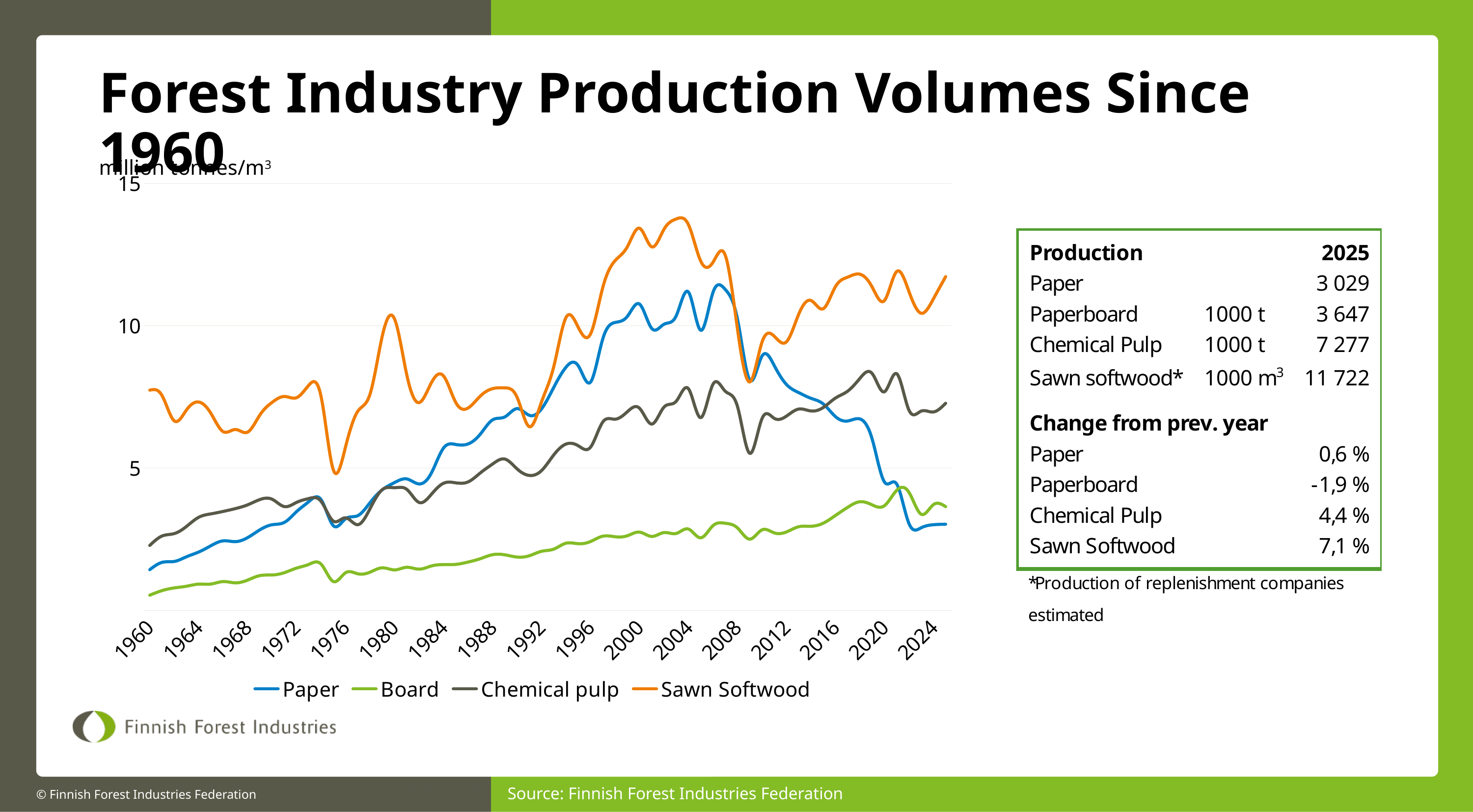
Is the value for Board in 1960 greater or less than 5? less In 2024, which is higher: Chemical pulp or Paper? Chemical pulp Does the Paper series rise or fall between 2008 and 2024? fall Is the value for Chemical pulp in 1960 greater or less than 5? less Which series has the highest value in 2024? Sawn Softwood Which series are listed in the chart's legend? Paper, Board, Chemical pulp, Sawn Softwood How many series does the chart's legend list? 4 Which series has the lowest value in 1960? Board What kind of chart is shown on the slide? line chart What unit label is shown above the chart's y axis? million tonnes/m³ Is the value for Paper in 2024 greater or less than 5? less